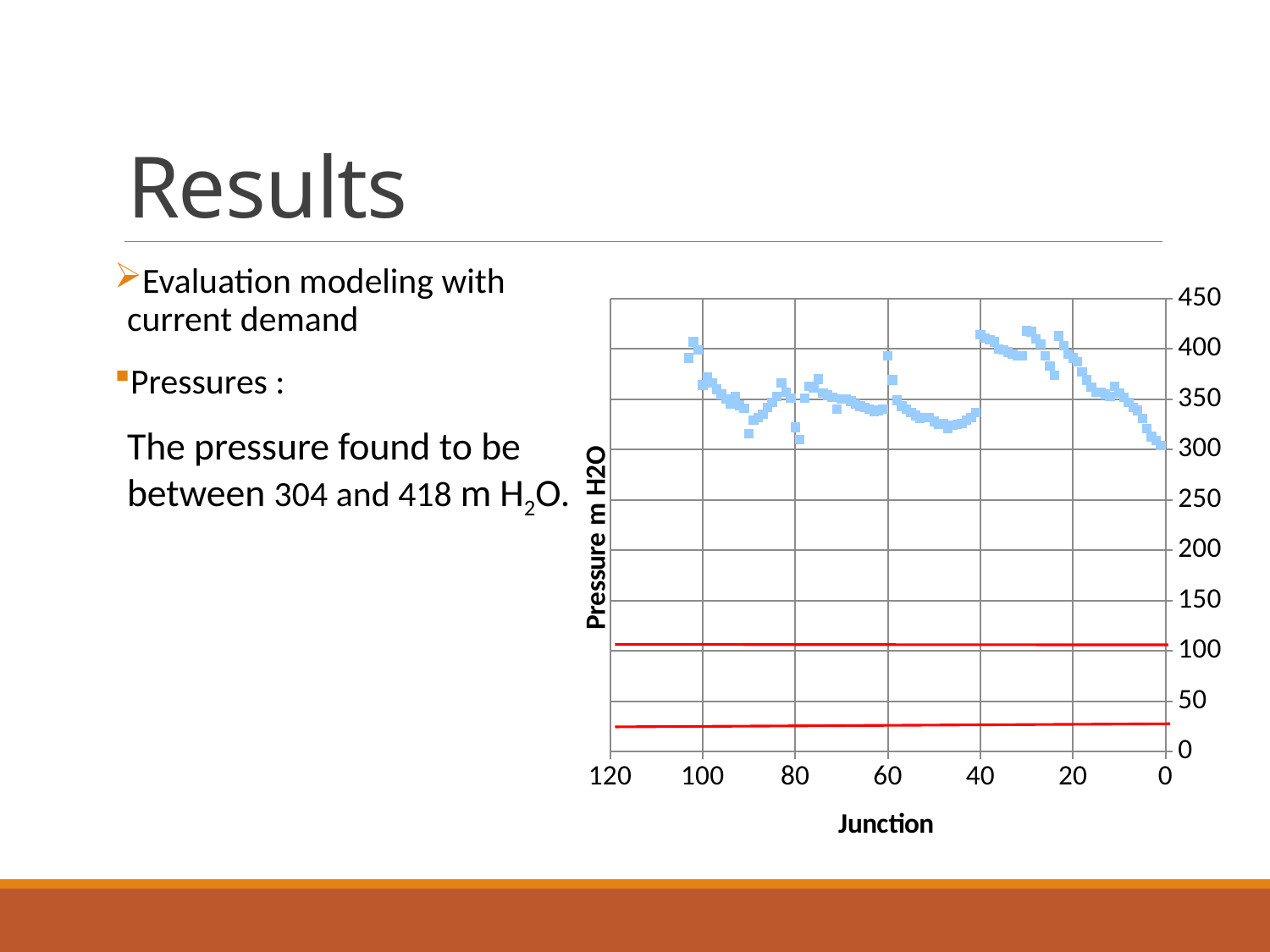
What kind of chart is shown on the slide? scatter chart What is the title of the horizontal axis of the chart? Junction Are the blue pressure points on the chart greater or less than 200? greater What is the title of the vertical axis of the chart? Pressure m H2O Is the lower red line on the chart greater or less than 50? less Is the upper red line on the chart greater or less than 50? greater Which red line on the chart has the larger value, the upper one or the lower one? the upper one